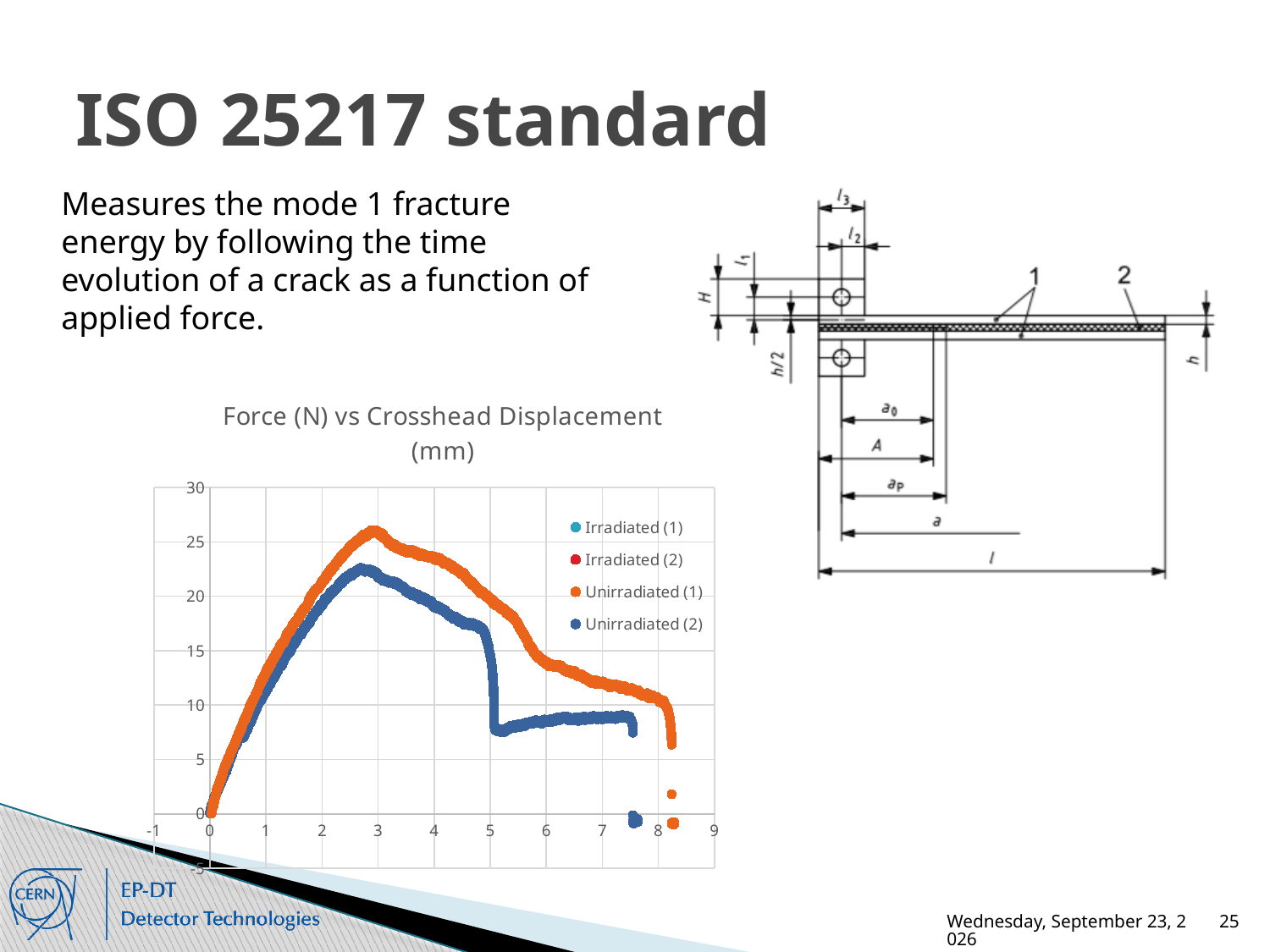
After the sharp drop near a displacement of 5 mm, is the force for Unirradiated (2) greater or less than 10? less Which legend entry is shown in orange? Unirradiated (1) Is the peak force for Unirradiated (2) greater or less than 20? greater What kind of chart is shown on the slide? scatter chart How many series does the chart legend list? 4 Does the force for Unirradiated (1) rise or fall between displacements of 3 mm and 8 mm? fall Does the force for Unirradiated (2) rise or fall between displacements of 0 mm and 2.5 mm? rise Is the peak force for Unirradiated (1) greater or less than 20? greater Which series reaches the higher peak force, Unirradiated (1) or Unirradiated (2)? Unirradiated (1) What is the title of the chart on the slide? Force (N) vs Crosshead Displacement (mm) What is the highest value shown on the vertical axis of the chart? 30